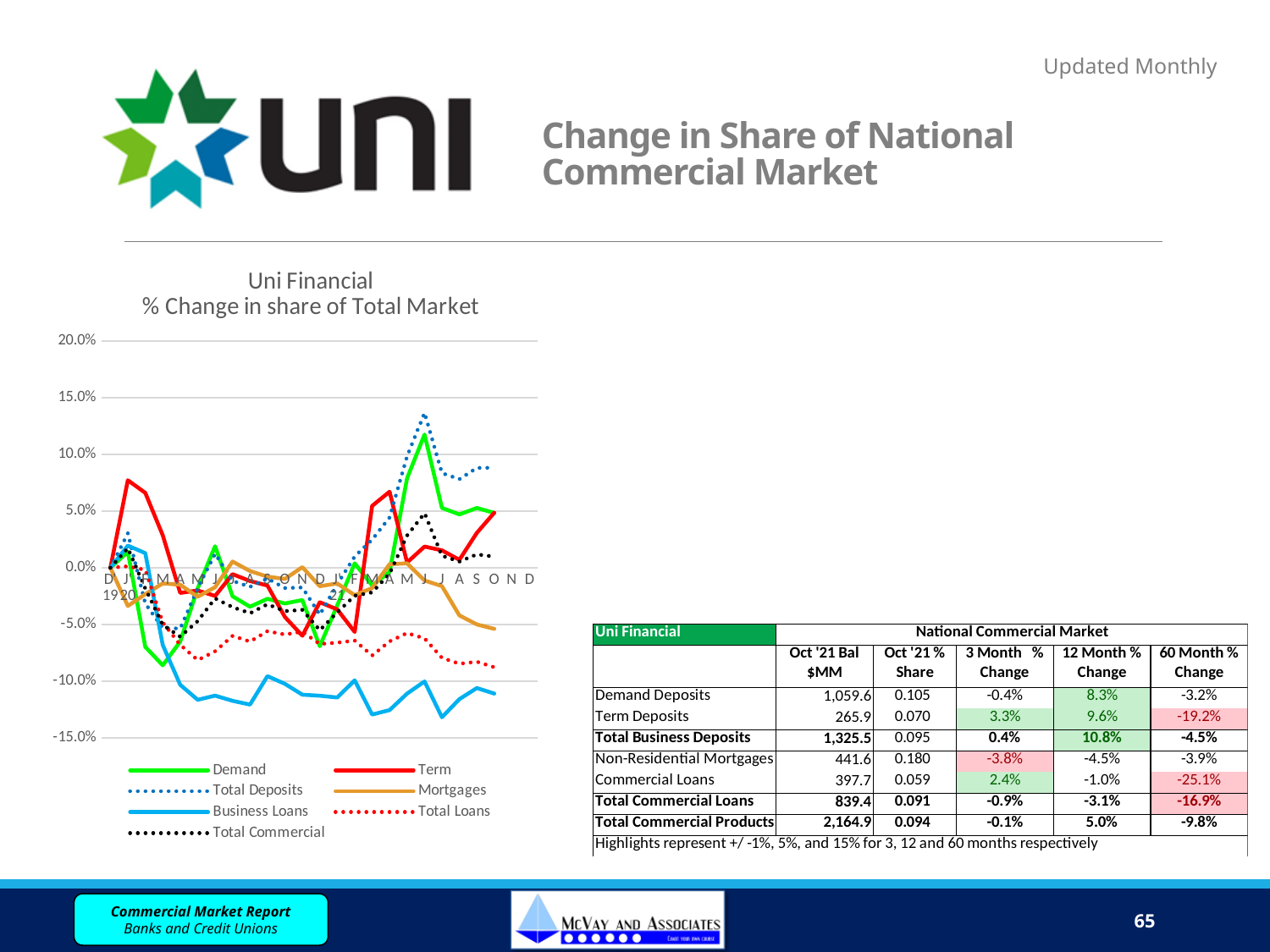
What colour is the Term line in the chart? Red What is the highest value shown on the chart's vertical axis? 20.0% Is the lowest value of the Business Loans line greater or less than -10.0%? less Does the Business Loans line overall rise or fall from the first point to the last point on the x axis? fall Is the value of the Business Loans line at the last point on the x axis greater or less than -5.0%? less Does the Total Deposits line overall rise or fall from the first point to the last point on the x axis? rise Is the peak value of the Demand line greater or less than 10.0%? greater What kind of chart is shown on the slide? Line chart What is the title of the chart? Uni Financial % Change in share of Total Market Which series reaches the lowest value on the chart? Business Loans How many series does the chart legend list? 7